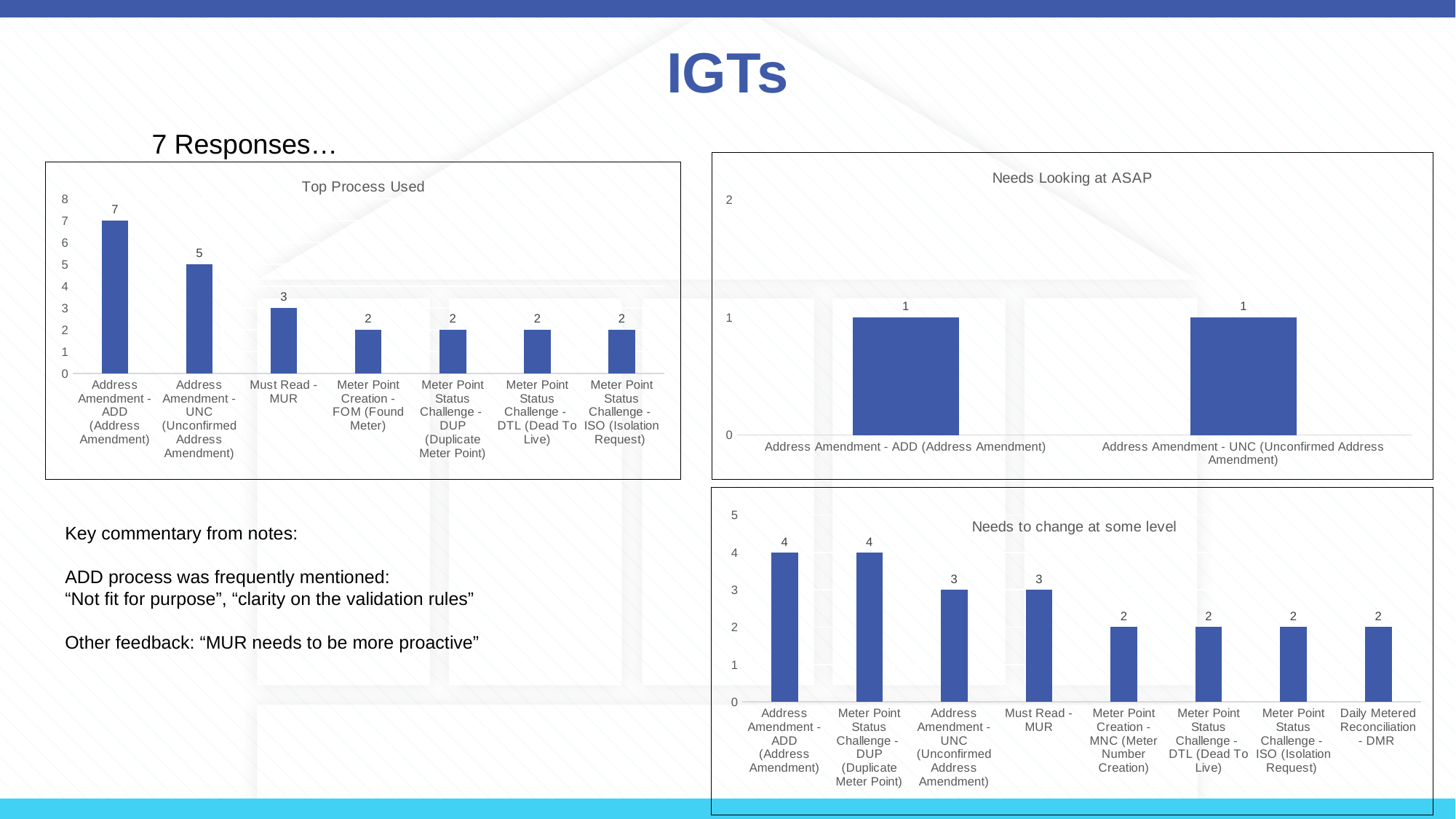
In the 'Top Process Used' chart, how many categories are shown? 7 In the 'Needs Looking at ASAP' chart, what is the value for Address Amendment - UNC (Unconfirmed Address Amendment)? 1 In the 'Needs to change at some level' chart, how many categories are shown? 8 In the 'Needs to change at some level' chart, which category has the lowest value among Address Amendment - ADD and Daily Metered Reconciliation - DMR? Daily Metered Reconciliation - DMR In the 'Needs to change at some level' chart, what is the value for Must Read - MUR? 3 In the 'Needs to change at some level' chart, what is the difference between Meter Point Status Challenge - DUP and Meter Point Creation - MNC? 2 In the 'Top Process Used' chart, what is the value for Must Read - MUR? 3 What type of chart is the 'Top Process Used' chart? Bar chart In the 'Top Process Used' chart, what is the difference between Address Amendment - ADD and Address Amendment - UNC? 2 In the 'Needs Looking at ASAP' chart, how many categories are shown? 2 In the 'Top Process Used' chart, which category has the highest value? Address Amendment - ADD (Address Amendment) In the 'Top Process Used' chart, what is the value for Address Amendment - ADD (Address Amendment)? 7